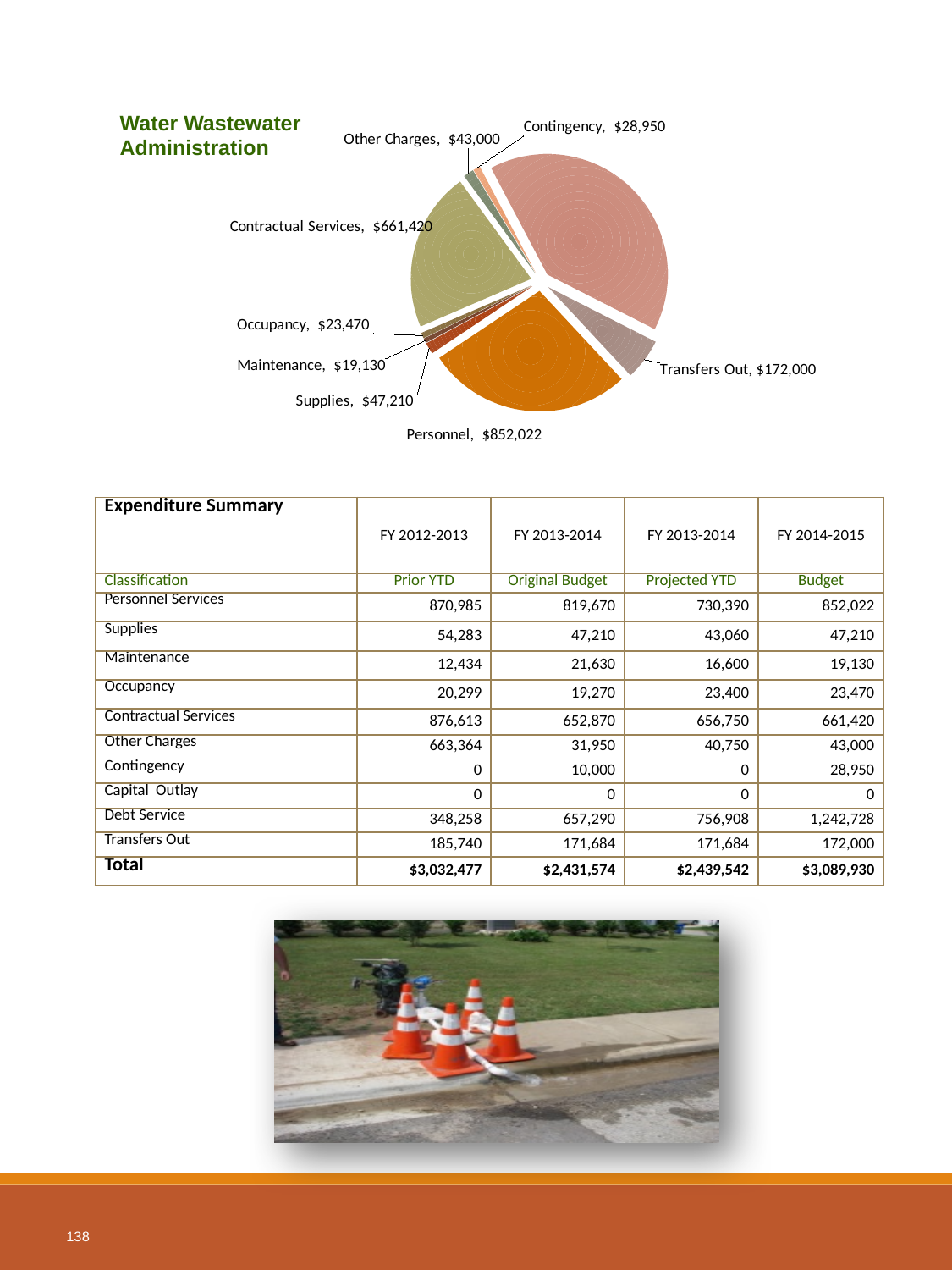
Which category has the smallest slice in the pie chart? Maintenance Which is larger in the pie chart, Supplies or Other Charges? Supplies What is the value for Contractual Services in the pie chart? $661,420 What is the difference between the Transfers Out and Other Charges values in the pie chart? $129,000 What is the title of the chart? Water Wastewater Administration What is the value for Transfers Out in the pie chart? $172,000 What is the value for Personnel in the pie chart? $852,022 What is the difference between the Personnel and Contractual Services values in the pie chart? $190,602 What type of chart is shown on the slide? Pie chart What is the value for Contingency in the pie chart? $28,950 How many slices does the pie chart have? 9